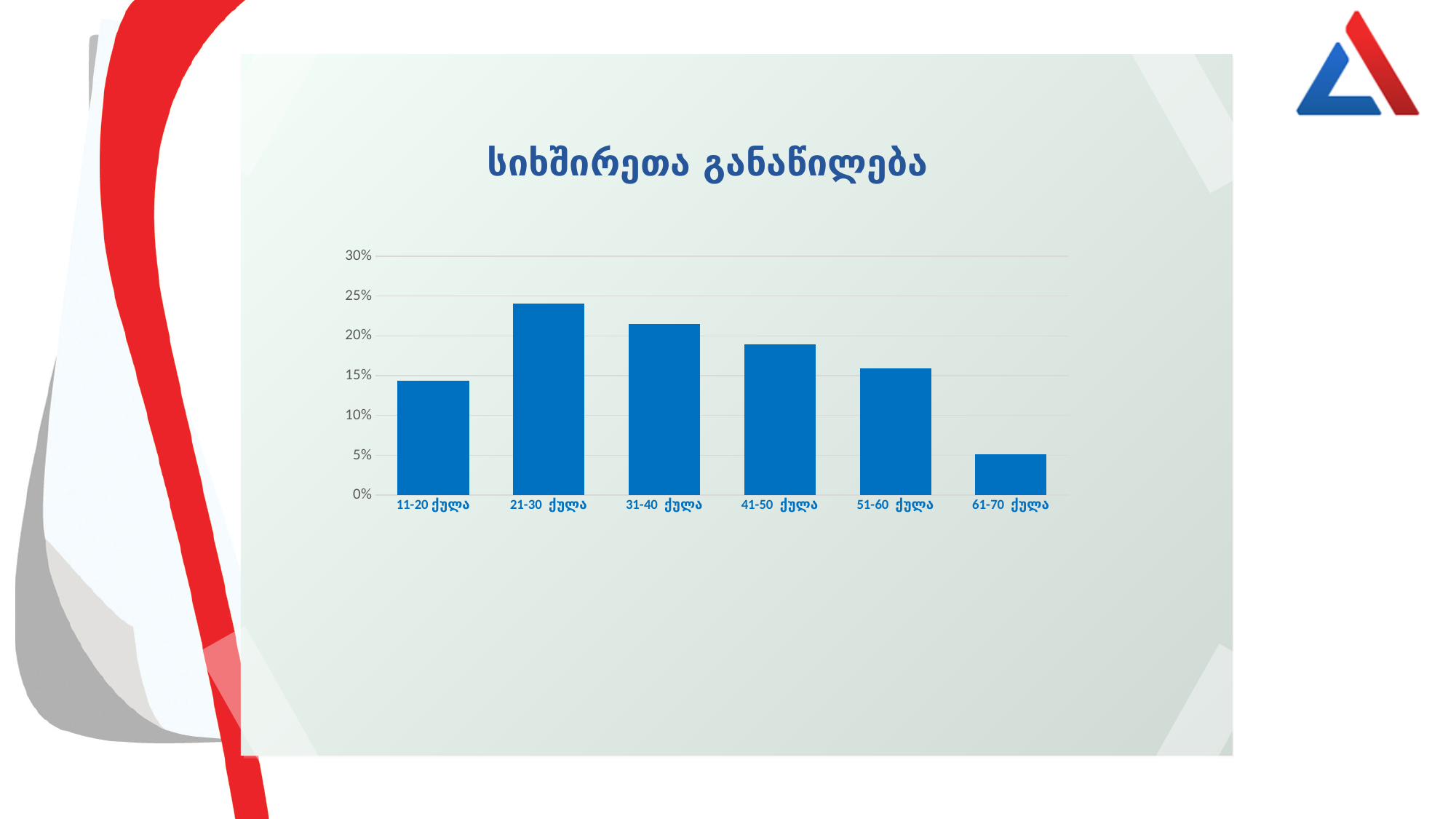
Which category has the lowest bar? 61-70 ქულა Is the value for 41-50 ქულა greater or less than 20%? less What is the title of the chart? სიხშირეთა განაწილება Which is larger, the value for 41-50 ქულა or the value for 51-60 ქულა? 41-50 ქულა How many categories are shown on the x axis of the chart? 6 Is the value for 61-70 ქულა greater or less than 10%? less Is the value for 31-40 ქულა greater or less than 20%? greater What kind of chart is shown on the slide? bar chart Which category has the highest bar? 21-30 ქულა Which is larger, the value for 21-30 ქულა or the value for 31-40 ქულა? 21-30 ქულა Do the values rise or fall from 21-30 ქულა to 61-70 ქულა? fall